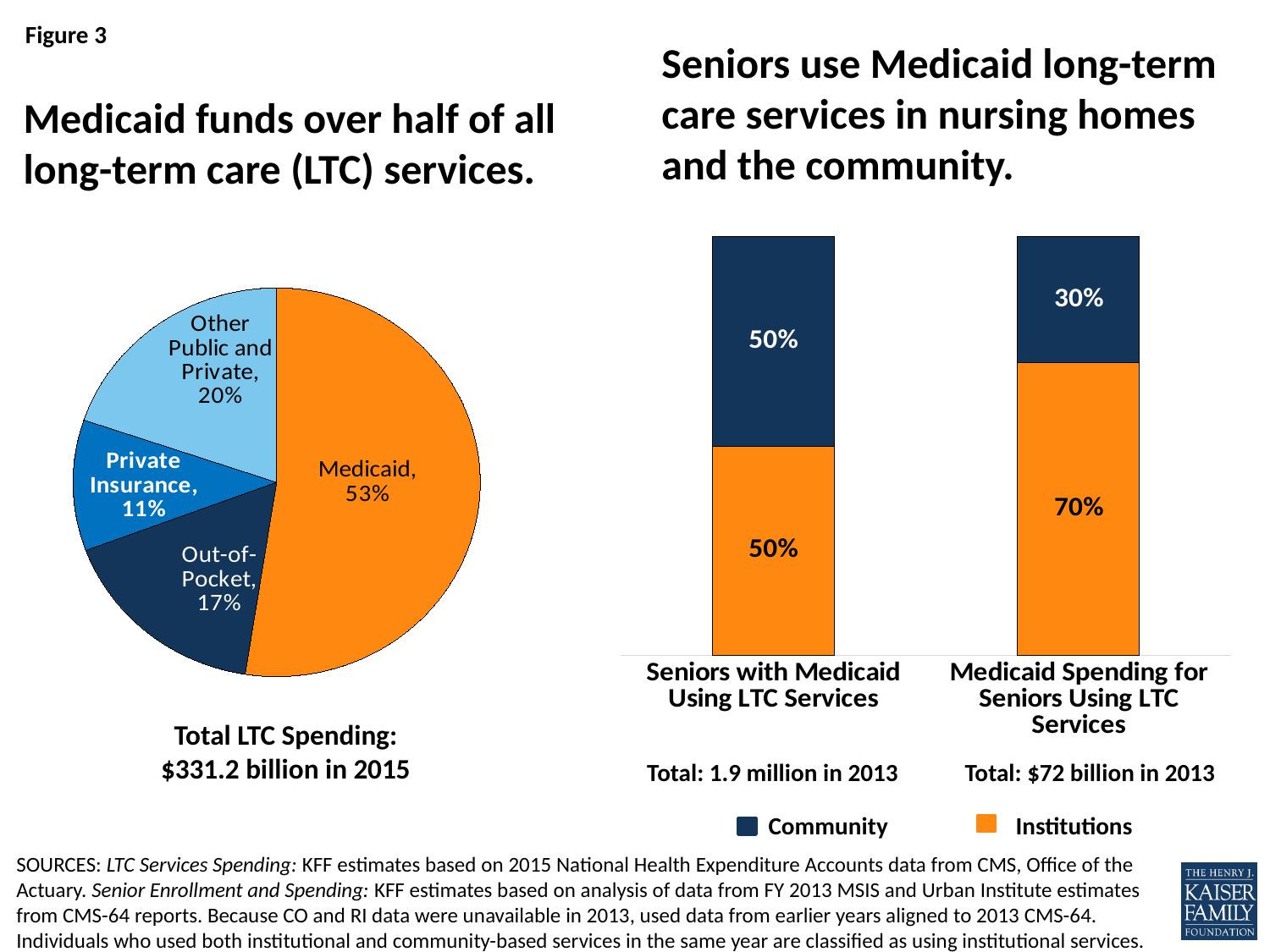
In the bar chart on the right, what is the Institutions value for Medicaid Spending for Seniors Using LTC Services? 70% In the pie chart on the left, which is larger: Out-of-Pocket or Private Insurance? Out-of-Pocket In the bar chart on the right, what is the total of the stacked bar for Medicaid Spending for Seniors Using LTC Services? 100% In the pie chart on the left, how many slices are there? 4 In the pie chart on the left, what is the difference between the Medicaid share and the Other Public and Private share? 33 percentage points In the bar chart on the right, how many series does the legend list? 2 What kind of chart is shown on the right side of the slide? Stacked bar chart In the bar chart on the right, what is the Community value for Seniors with Medicaid Using LTC Services? 50% In the pie chart on the left, what share of total LTC spending is Out-of-Pocket? 17% In the pie chart on the left, what share of total LTC spending is Medicaid? 53% In the pie chart on the left, which category has the largest share? Medicaid In the pie chart on the left, which category has the smallest share? Private Insurance